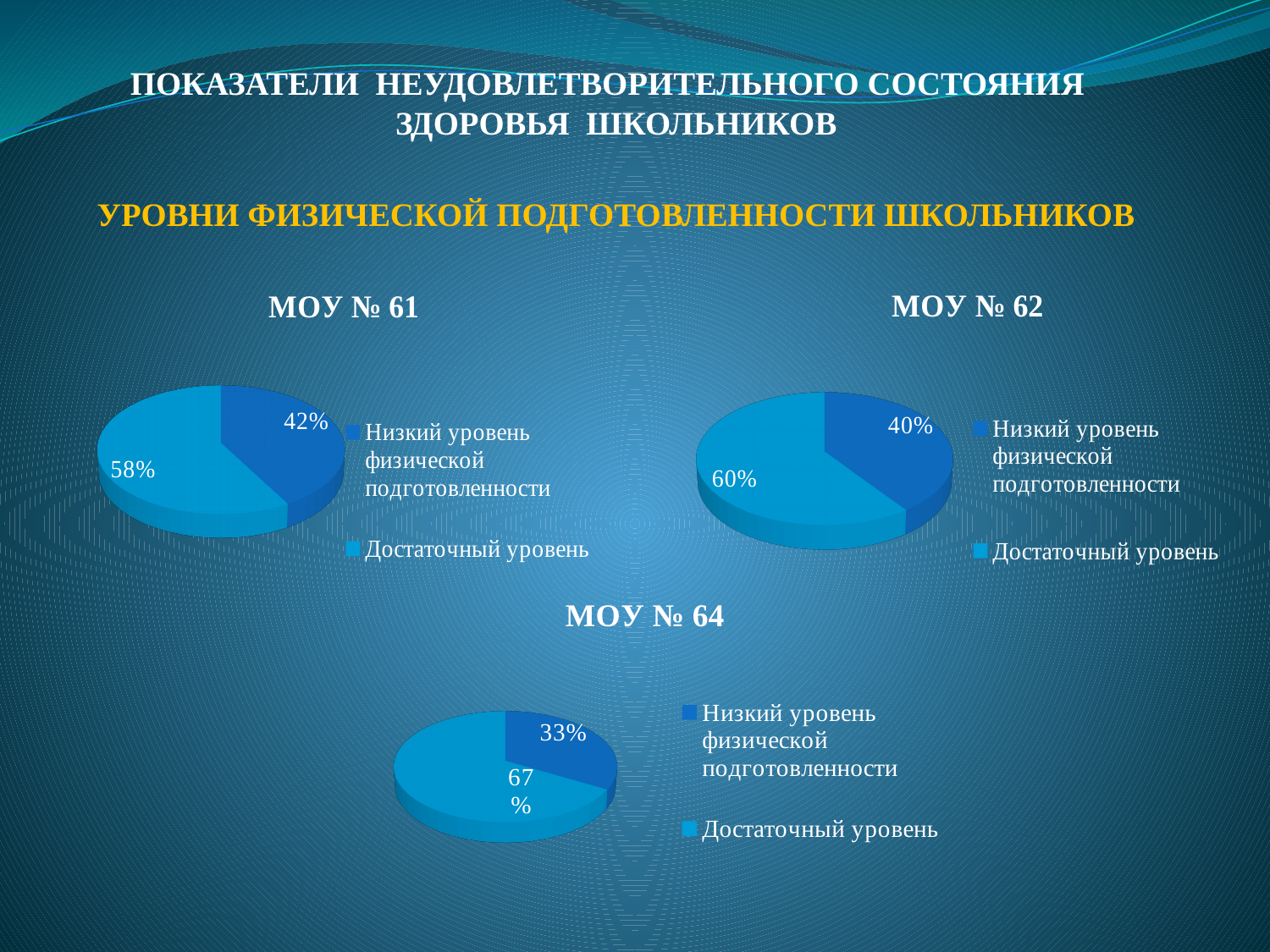
In the МОУ № 62 chart, what share is labelled for 'Низкий уровень физической подготовленности'? 40% In the МОУ № 64 chart, what share is labelled for 'Низкий уровень физической подготовленности'? 33% In the МОУ № 64 chart, which category has the larger slice? Достаточный уровень In the МОУ № 64 chart, what share is labelled for 'Достаточный уровень'? 67% In the МОУ № 62 chart, what share is labelled for 'Достаточный уровень'? 60% How many categories does the legend of the МОУ № 64 chart list? 2 Which is larger: the 'Низкий уровень физической подготовленности' share in the МОУ № 61 chart or in the МОУ № 64 chart? МОУ № 61 In the МОУ № 61 chart, what share is labelled for 'Низкий уровень физической подготовленности'? 42% What type of chart is used for МОУ № 62? Pie chart In the МОУ № 61 chart, what share is labelled for 'Достаточный уровень'? 58% In the МОУ № 62 chart, what is the difference between the 'Достаточный уровень' share and the 'Низкий уровень физической подготовленности' share? 20% In the МОУ № 61 chart, which category has the smaller slice? Низкий уровень физической подготовленности